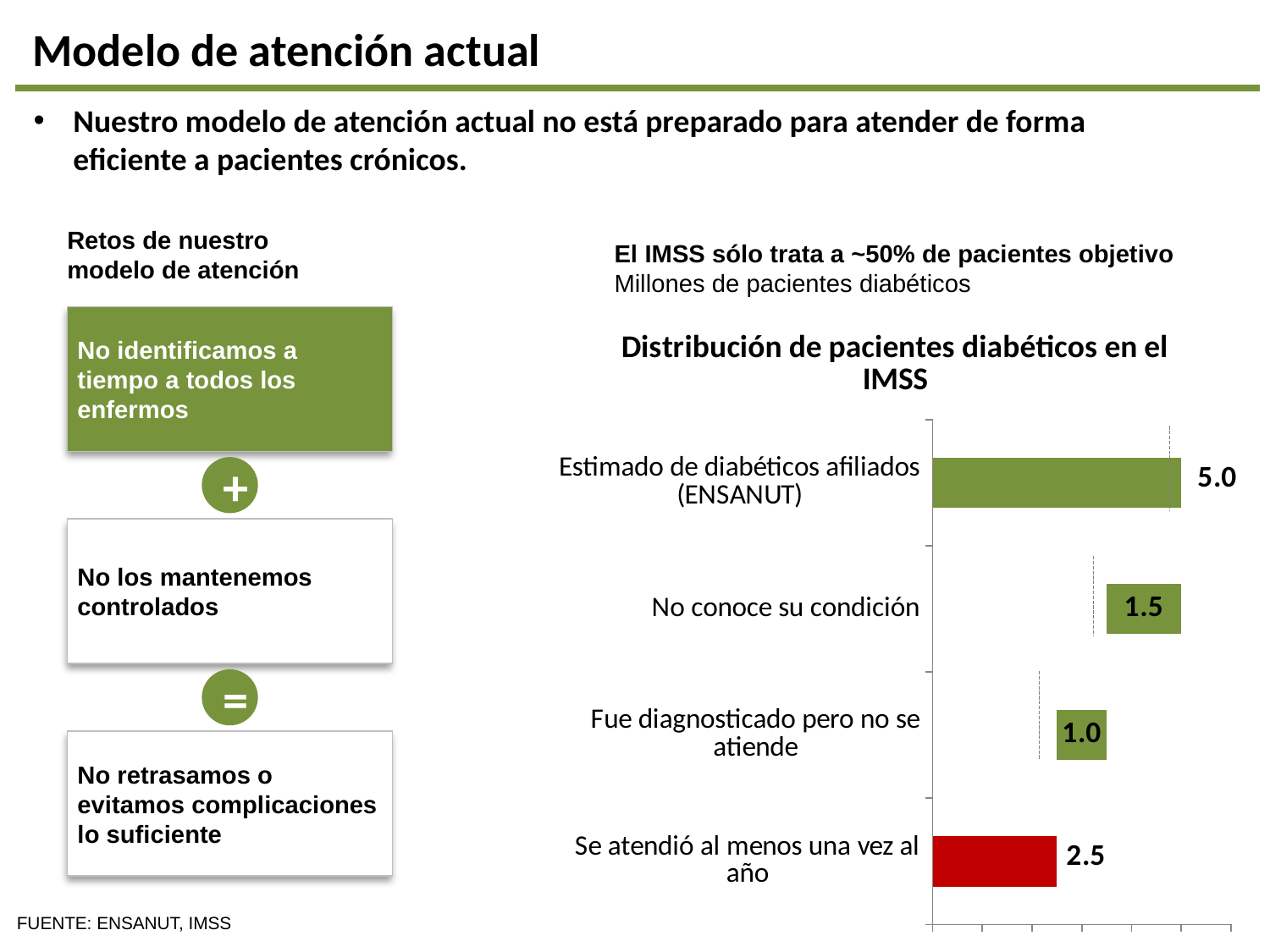
What is the value for 'No conoce su condición'? 1.5 What is the difference between 'Se atendió al menos una vez al año' and 'No conoce su condición'? 1.0 Which category has the highest value? Estimado de diabéticos afiliados (ENSANUT) What is the value for 'Estimado de diabéticos afiliados (ENSANUT)'? 5.0 What kind of chart is shown on the slide? Bar chart Which is larger: 'No conoce su condición' or 'Fue diagnosticado pero no se atiende'? No conoce su condición Which category has the lowest value? Fue diagnosticado pero no se atiende What is the title of the chart? Distribución de pacientes diabéticos en el IMSS How many categories are shown in the chart? 4 What is the value for 'Fue diagnosticado pero no se atiende'? 1.0 What is the value for 'Se atendió al menos una vez al año'? 2.5 Which category's bar is coloured red? Se atendió al menos una vez al año